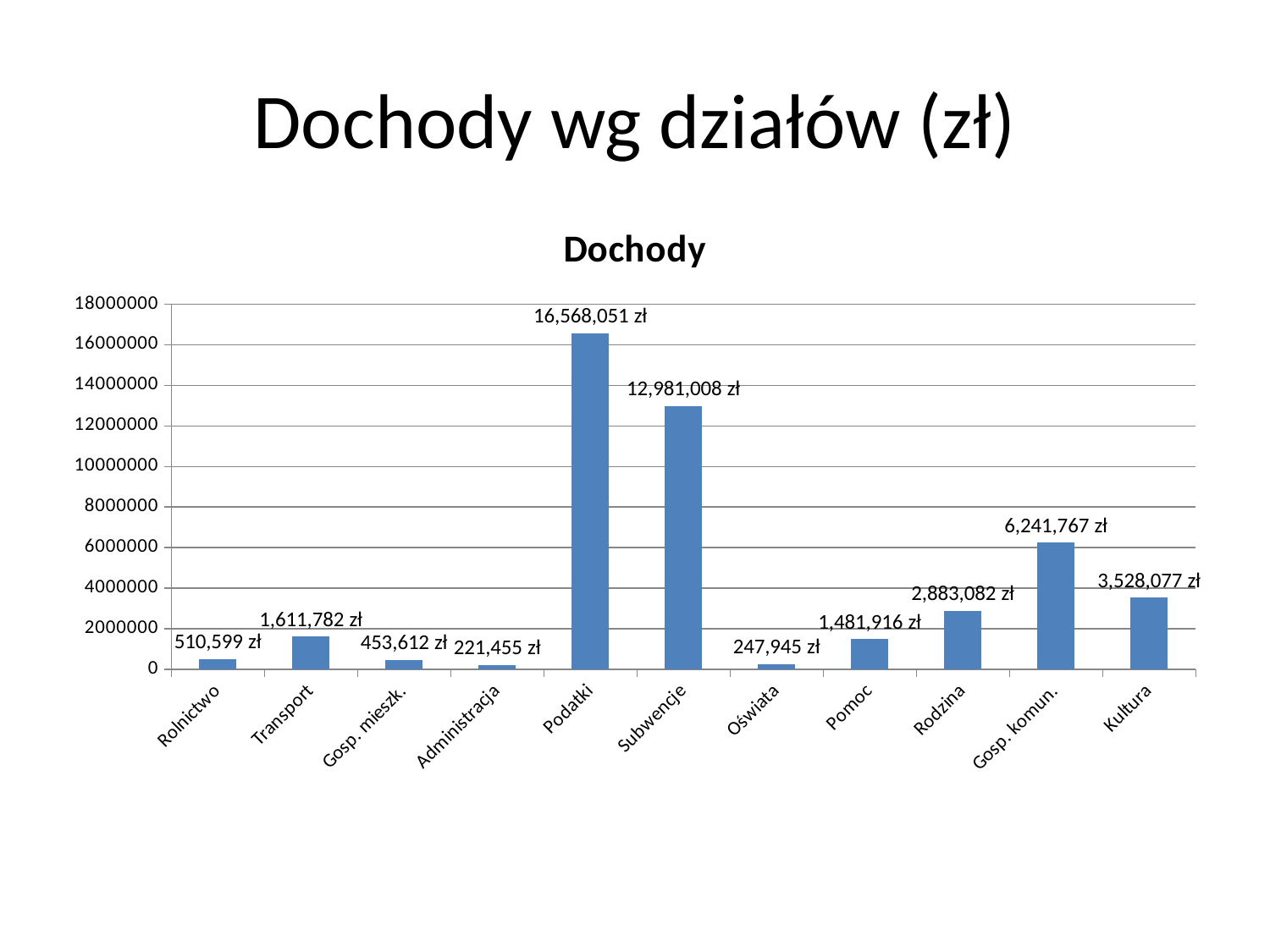
How many categories are shown on the x axis? 11 What is the title of the chart? Dochody Which category has the lowest value? Administracja Is the value for Kultura greater or less than 2000000? greater What is the value for Podatki? 16,568,051 zł What kind of chart is shown on the slide? bar chart Which is larger, the value for Transport or the value for Pomoc? Transport What is the difference between the values for Podatki and Subwencje? 3,587,043 zł What is the difference between the values for Gosp. komun. and Kultura? 2,713,690 zł What is the value for Gosp. komun.? 6,241,767 zł Which category has the highest value? Podatki What is the value for Rolnictwo? 510,599 zł